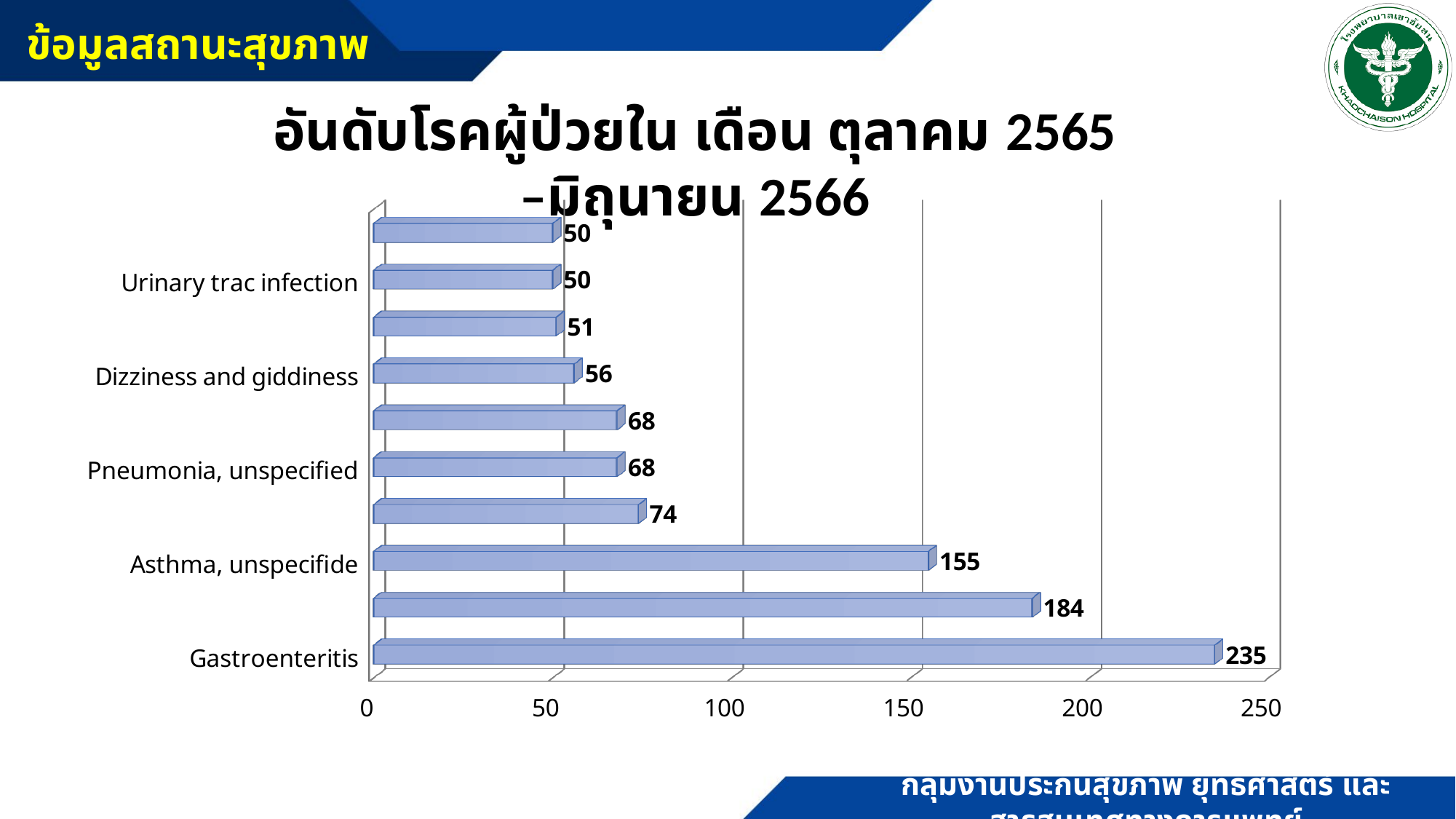
What is the value for Pneumonia, unspecified? 68 What kind of chart is shown on the slide? bar chart Is the value for Gastroenteritis greater or less than 200? greater What is the value for Dizziness and giddiness? 56 Which is larger, the value for Asthma, unspecifide or the value for Pneumonia, unspecified? Asthma, unspecifide What is the value for Asthma, unspecifide? 155 What is the value for Urinary trac infection? 50 What is the difference between the values for Pneumonia, unspecified and Dizziness and giddiness? 12 What is the difference between the values for Gastroenteritis and Asthma, unspecifide? 80 Which category has the highest value? Gastroenteritis How many bars are plotted in the chart? 10 What is the value for Gastroenteritis? 235